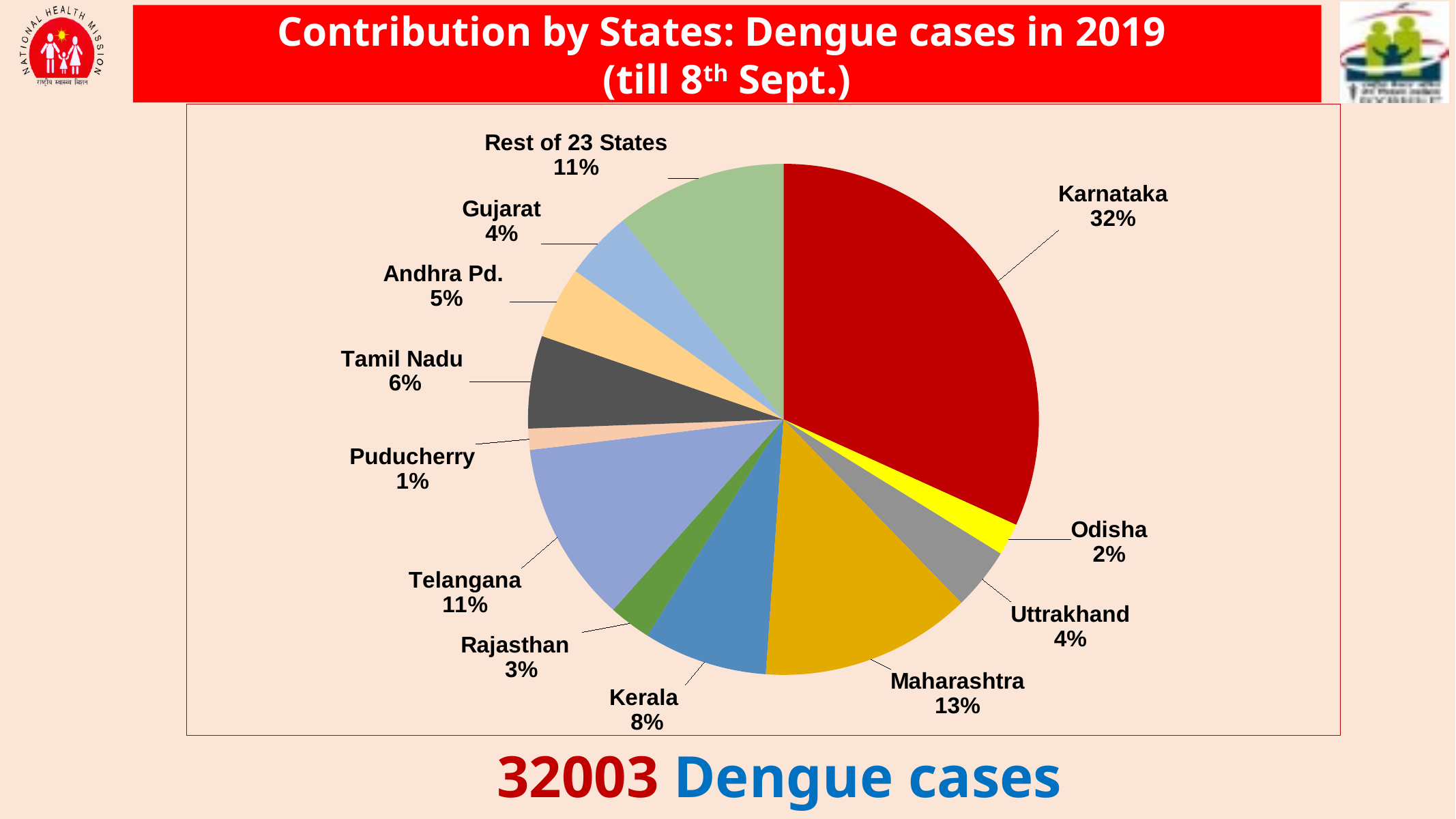
What percentage of dengue cases is attributed to Maharashtra? 13% Which has a larger share, Tamil Nadu or Andhra Pd.? Tamil Nadu What percentage is shown for Rest of 23 States? 11% Which slice has the smallest share? Puducherry What type of chart is shown on the slide? Pie chart Which state has the largest share of dengue cases? Karnataka What is the combined share of Telangana and Kerala? 19% What is the difference in percentage points between Karnataka and Maharashtra? 19 What is the share for Kerala? 8% What share of dengue cases does Karnataka contribute? 32% What total number of dengue cases is stated below the chart? 32003 How many slices does the pie chart have? 12